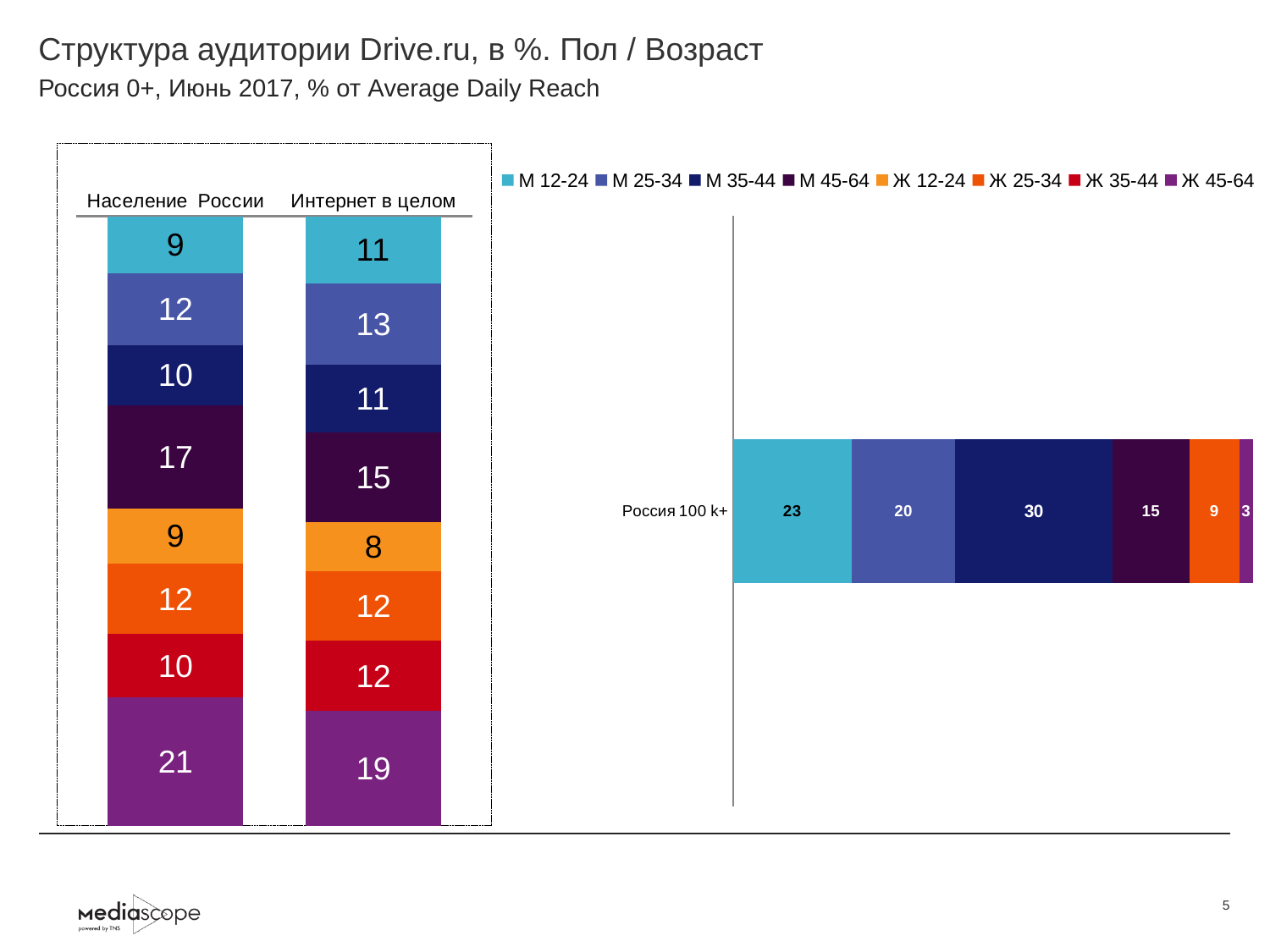
In the right chart (Россия 100 k+), what is the value for М 35-44? 30 In the left chart, what is the value for Ж 45-64 in the Интернет в целом bar? 19 In the right chart (Россия 100 k+), which series has the largest segment? М 35-44 In the left chart, what is the value for М 45-64 in the Население России bar? 17 In the left chart, which series has the smallest segment in the Интернет в целом bar? Ж 12-24 What kind of chart is the right chart (Россия 100 k+)? Stacked bar chart In the right chart (Россия 100 k+), what is the value for М 12-24? 23 In the left chart, what is the difference between the М 45-64 values for Население России and Интернет в целом? 2 In the right chart (Россия 100 k+), what is the difference between the М 12-24 and М 25-34 values? 3 In the left chart, which is larger: М 25-34 for Население России or М 25-34 for Интернет в целом? Интернет в целом How many series does the legend list? 8 In the left chart, which series has the largest segment in the Население России bar? Ж 45-64